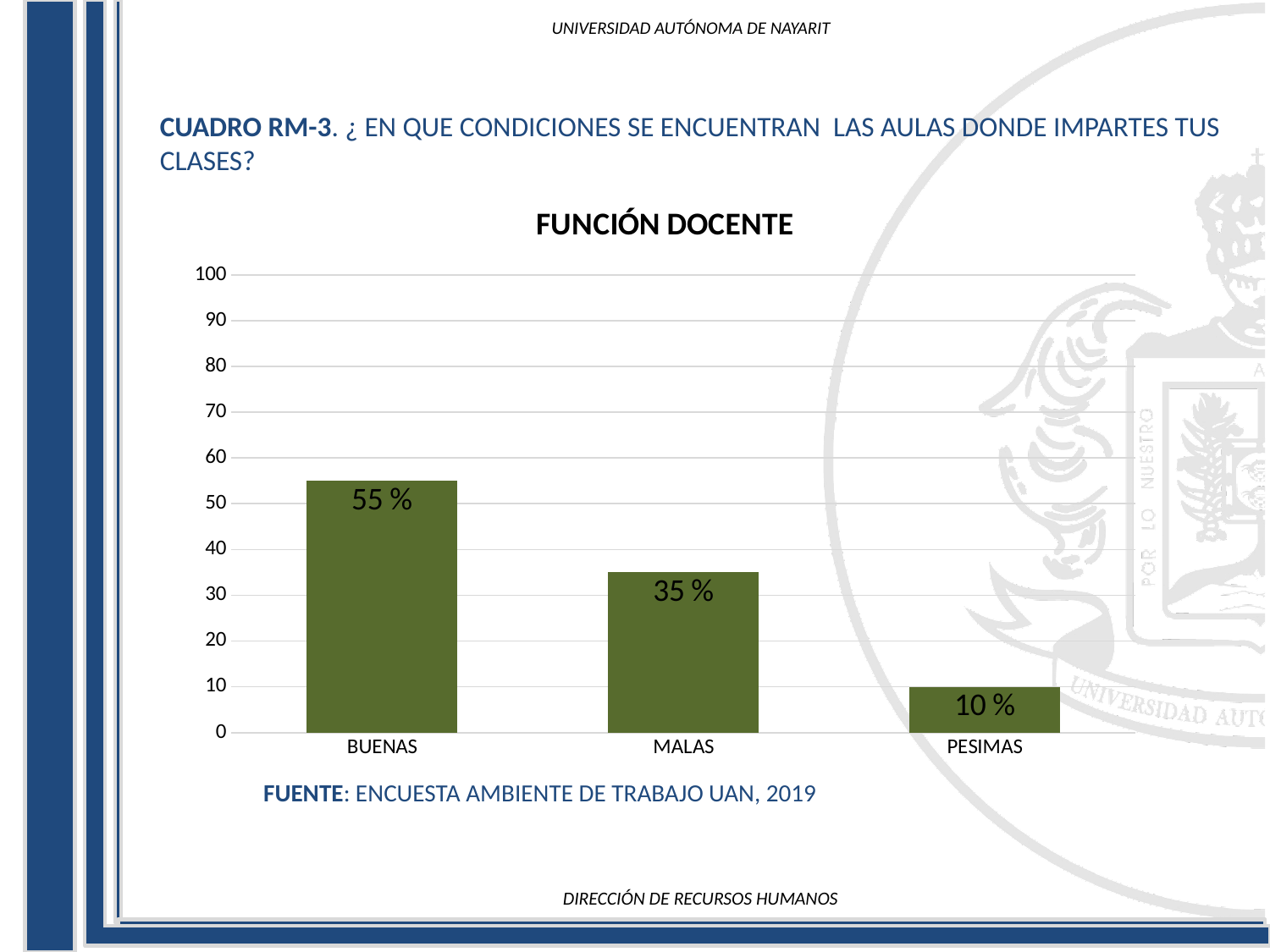
What is the difference between the values for BUENAS and MALAS? 20 % What is the difference between the values for MALAS and PESIMAS? 25 % What is the title of the chart? FUNCIÓN DOCENTE Which is larger, the value for MALAS or the value for PESIMAS? MALAS What is the value for PESIMAS? 10 % Which category has the lowest value? PESIMAS What is the value for MALAS? 35 % What kind of chart is shown? bar chart Is the value for BUENAS greater or less than 50? greater How many categories are shown on the x axis? 3 What is the value for BUENAS? 55 % Which category has the highest value? BUENAS